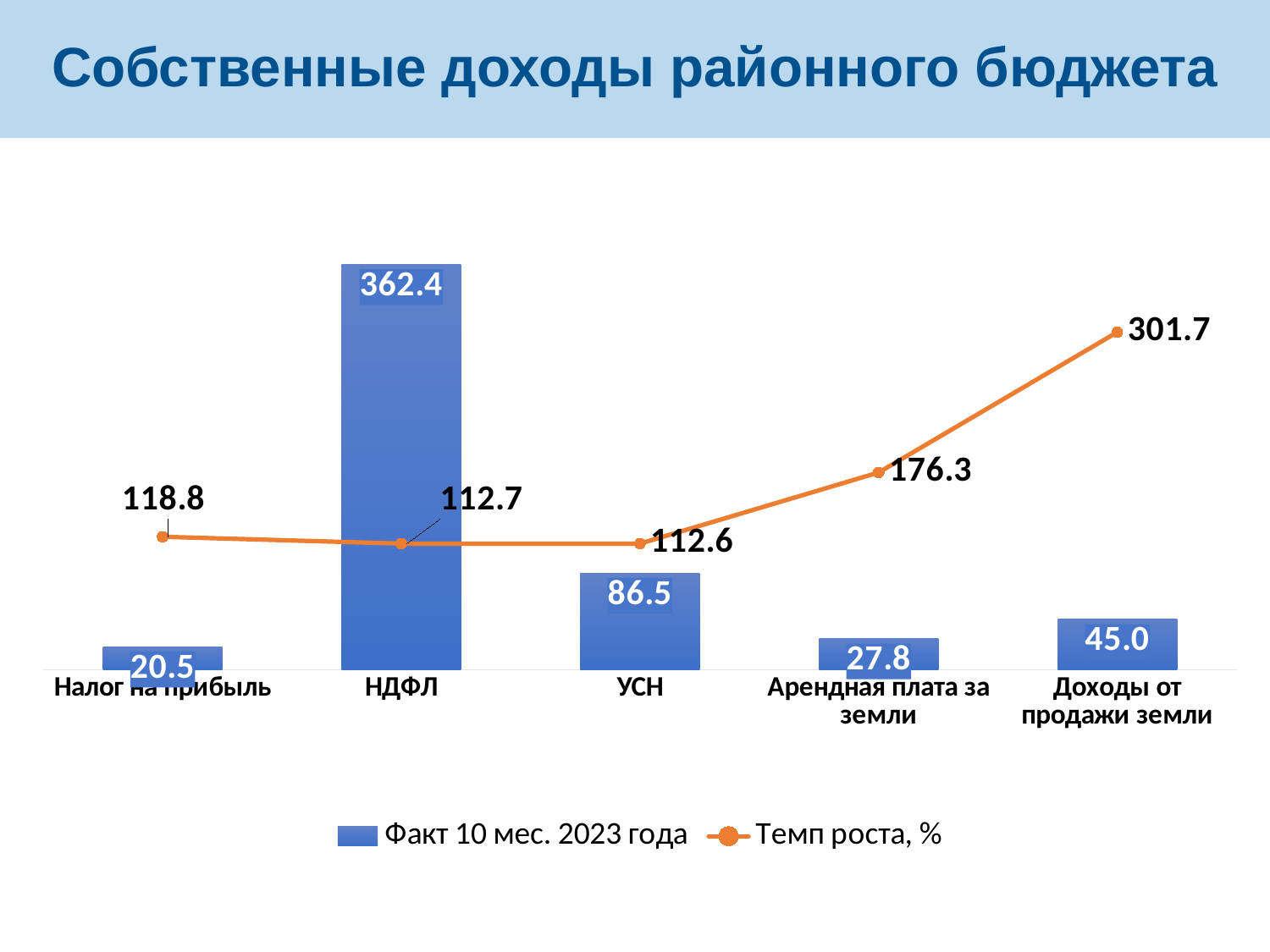
What is the title of the slide? Собственные доходы районного бюджета What is the "Темп роста, %" value for Налог на прибыль? 118.8 Which is larger, the "Факт 10 мес. 2023 года" value for УСН or for Доходы от продажи земли? УСН What is the "Темп роста, %" value for Доходы от продажи земли? 301.7 How many categories are shown on the x axis? 5 How many series does the legend list? 2 What is the "Факт 10 мес. 2023 года" value for Арендная плата за земли? 27.8 What is the difference between the "Факт 10 мес. 2023 года" values for НДФЛ and УСН? 275.9 What is the value of "Факт 10 мес. 2023 года" for НДФЛ? 362.4 Which category has the highest "Факт 10 мес. 2023 года" value? НДФЛ Which category has the highest "Темп роста, %" value? Доходы от продажи земли Which category has the lowest "Факт 10 мес. 2023 года" value? Налог на прибыль